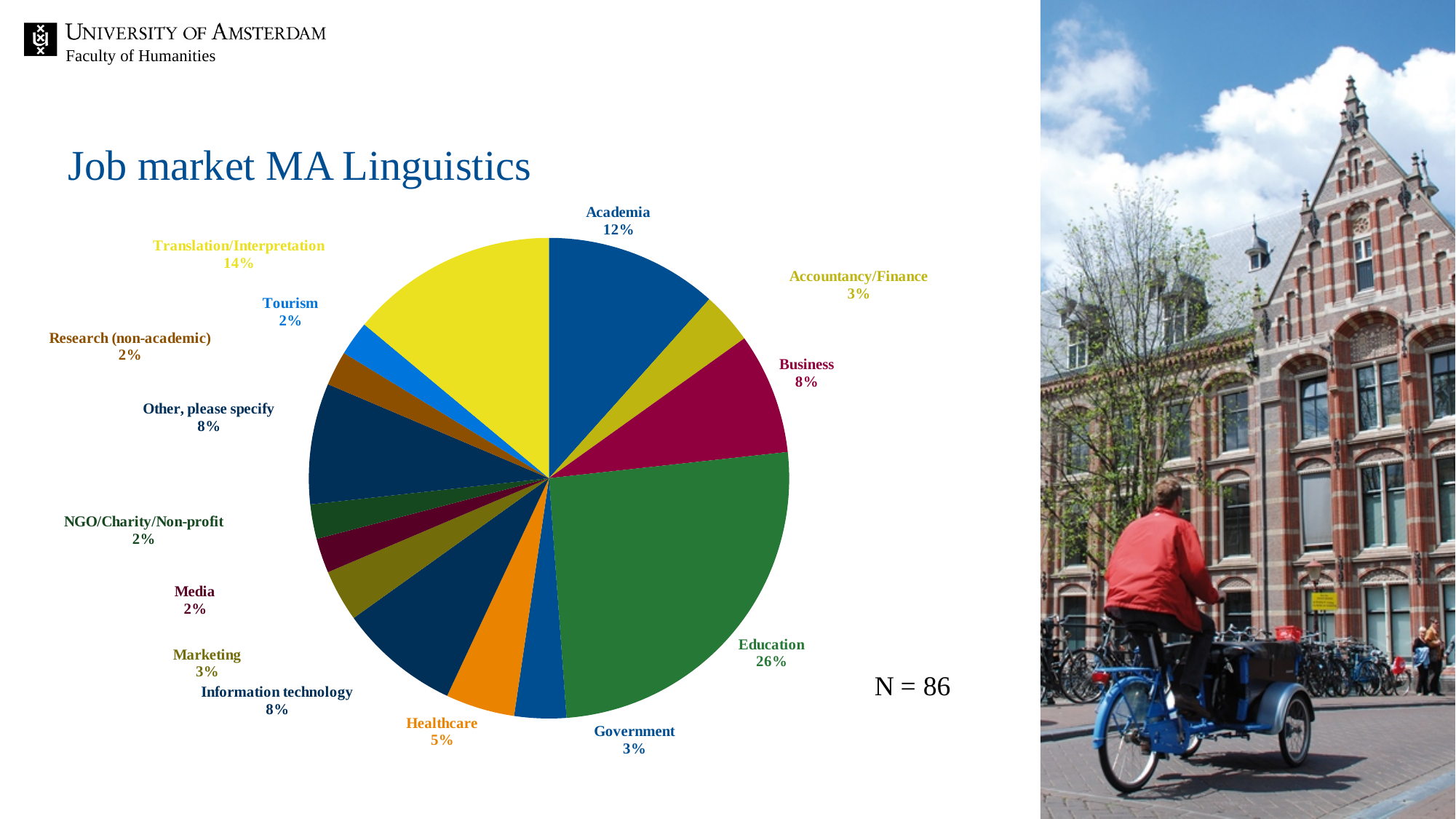
What sample size (N) is stated next to the chart? N = 86 How many categories are shown in the pie chart? 14 What is the difference between the Translation/Interpretation share and the Tourism share? 12% What share of the pie does Education represent? 26% What is the difference between the Education share and the Academia share? 14% Which is larger, the share for Business or the share for Healthcare? Business Which category has the largest slice of the pie? Education What is the title of the slide containing the chart? Job market MA Linguistics What is the value for Healthcare? 5% What is the value for Information technology? 8% What is the value for Translation/Interpretation? 14% What kind of chart is shown on the slide? pie chart